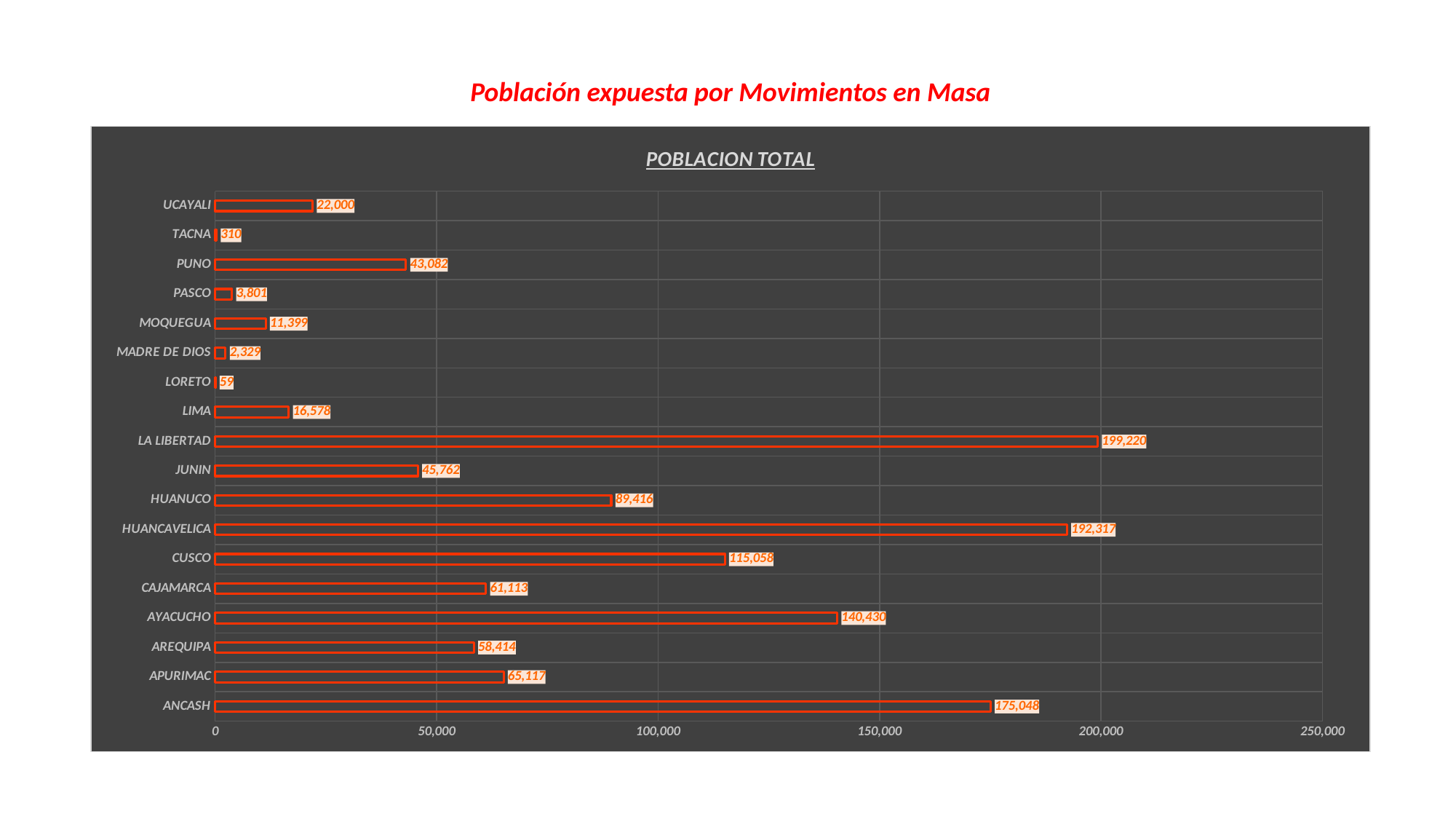
What is the value for LA LIBERTAD? 199,220 Which is larger, the value for CUSCO or the value for HUANUCO? CUSCO What kind of chart is shown on the slide? bar chart Is the value for ANCASH greater or less than 150,000? greater What is the value for AYACUCHO? 140,430 What is the title of the chart? POBLACION TOTAL Which category has the highest value? LA LIBERTAD How many categories are shown in the chart? 18 What is the difference between the values for ANCASH and AYACUCHO? 34,618 What is the difference between the values for LA LIBERTAD and HUANCAVELICA? 6,903 What is the value for MADRE DE DIOS? 2,329 Which category has the lowest value? LORETO